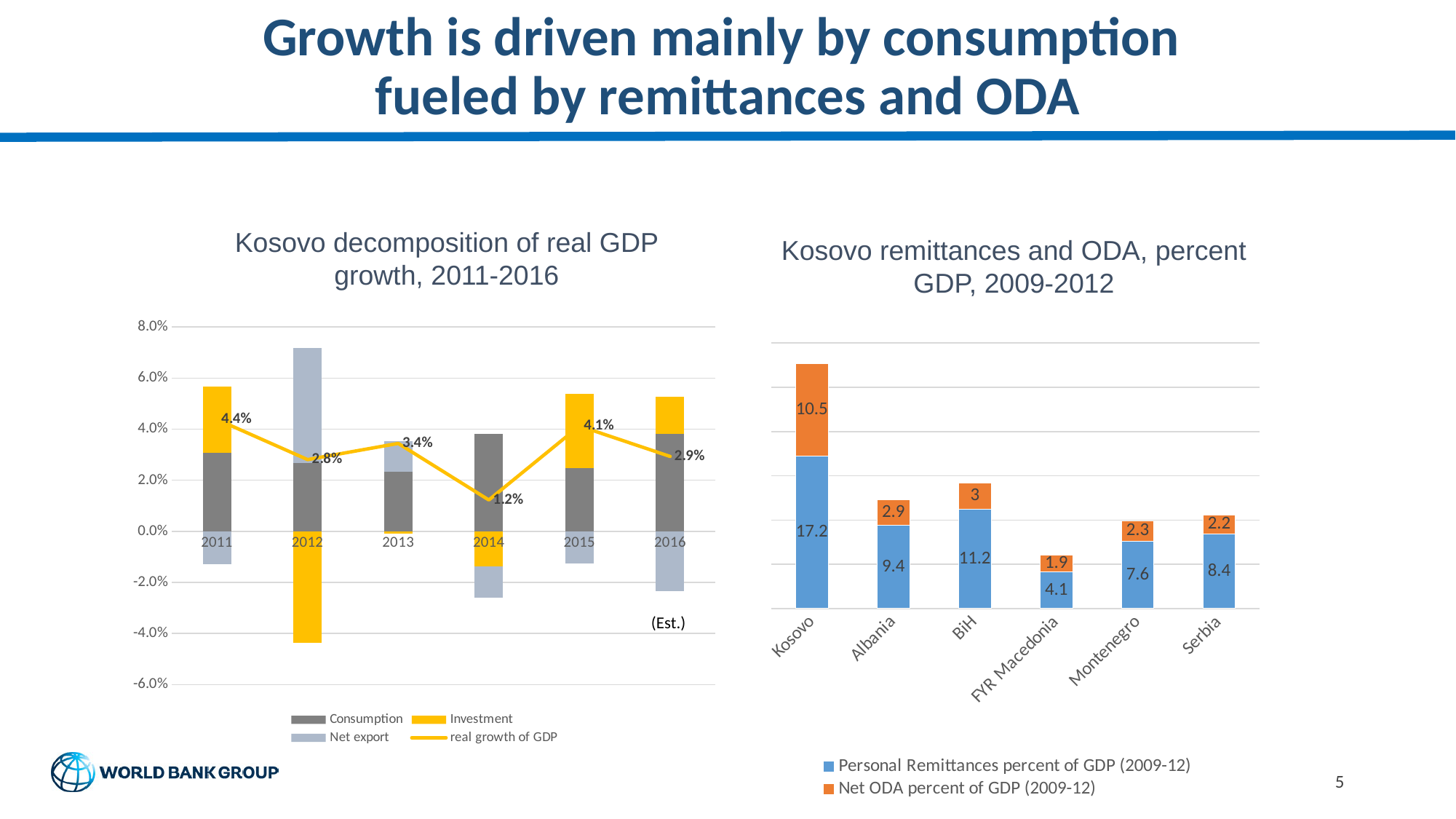
In the chart 'Kosovo remittances and ODA, percent GDP, 2009-2012', what is the value of Net ODA percent of GDP for BiH? 3 How many years are shown on the x axis of the chart 'Kosovo decomposition of real GDP growth, 2011-2016'? 6 In the chart 'Kosovo remittances and ODA, percent GDP, 2009-2012', which country has the lowest Personal Remittances percent of GDP? FYR Macedonia In the chart 'Kosovo remittances and ODA, percent GDP, 2009-2012', what is the total of the stacked bar for Albania? 12.3 In the chart 'Kosovo remittances and ODA, percent GDP, 2009-2012', what is the value of Personal Remittances percent of GDP for Kosovo? 17.2 What kind of chart is 'Kosovo remittances and ODA, percent GDP, 2009-2012'? Stacked bar chart How many series does the legend of the chart 'Kosovo decomposition of real GDP growth, 2011-2016' list? 4 In the chart 'Kosovo decomposition of real GDP growth, 2011-2016', which year had the lowest real growth of GDP? 2014 In the chart 'Kosovo decomposition of real GDP growth, 2011-2016', what is the difference between real growth of GDP in 2015 and in 2014? 2.9% In the chart 'Kosovo decomposition of real GDP growth, 2011-2016', which year had the highest real growth of GDP? 2011 In the chart 'Kosovo decomposition of real GDP growth, 2011-2016', what was real growth of GDP in 2011? 4.4% In the chart 'Kosovo decomposition of real GDP growth, 2011-2016', was real growth of GDP higher in 2012 or in 2013? 2013